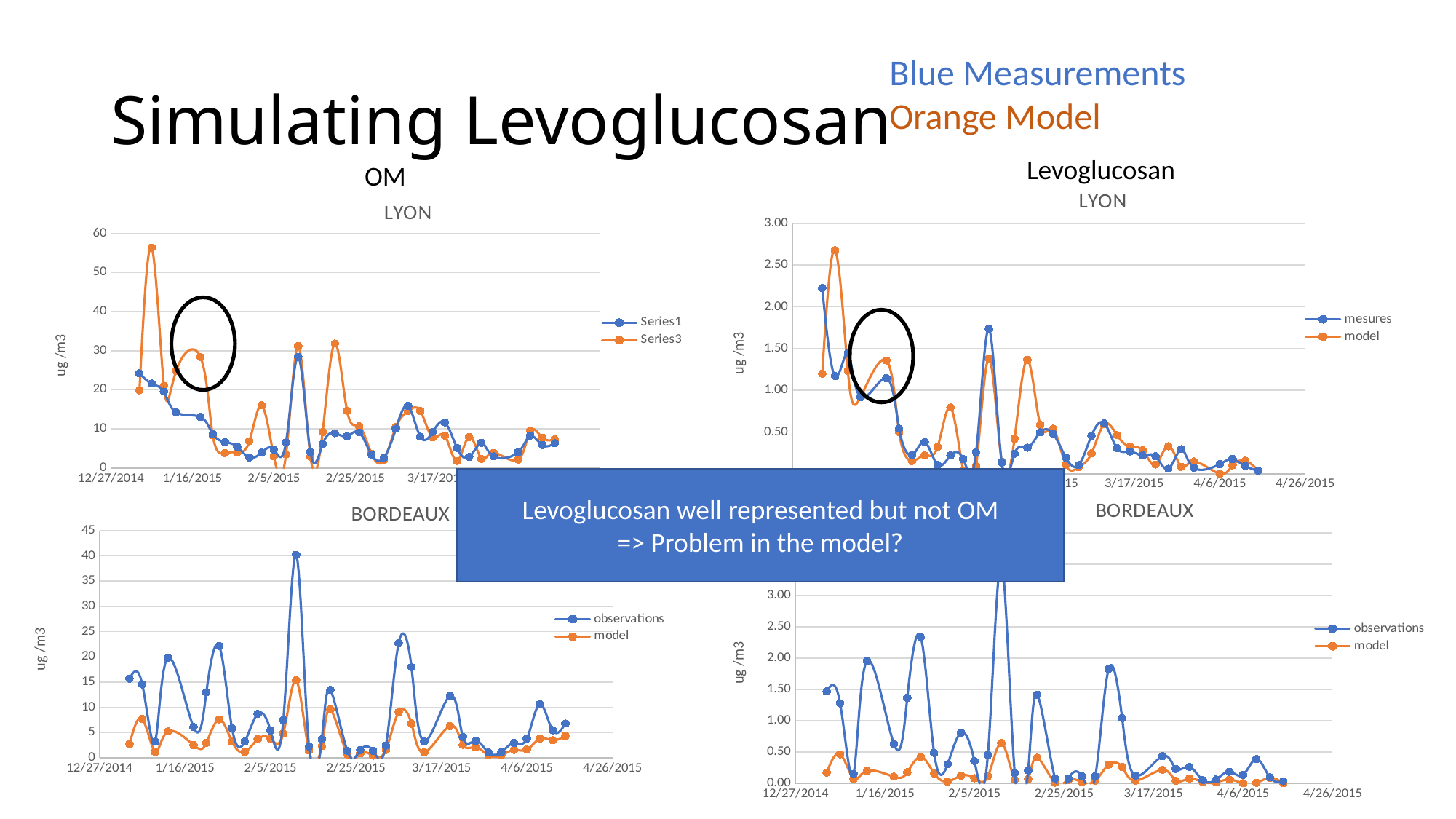
In the OM LYON chart, is the highest value of the orange Series3 line greater or less than 50? greater In the Levoglucosan LYON chart, is the highest value of the model line greater or less than 2.50? greater In the OM BORDEAUX chart, which series reaches the higher peak value, observations or model? observations In the OM BORDEAUX chart at the bottom left, is the highest value of the observations line greater or less than 35? greater What label is shown on the vertical axis of the OM BORDEAUX chart? ug /m3 How many series does the legend of the Levoglucosan BORDEAUX chart list? 2 What kind of chart is the OM LYON chart at the top left of the slide? line chart How many charts are shown on the slide? 4 How many series does the legend of the OM LYON chart list? 2 In the Levoglucosan LYON chart, do the values generally rise or fall from left to right along the date axis? fall What are the two legend entries of the Levoglucosan LYON chart at the top right? mesures and model